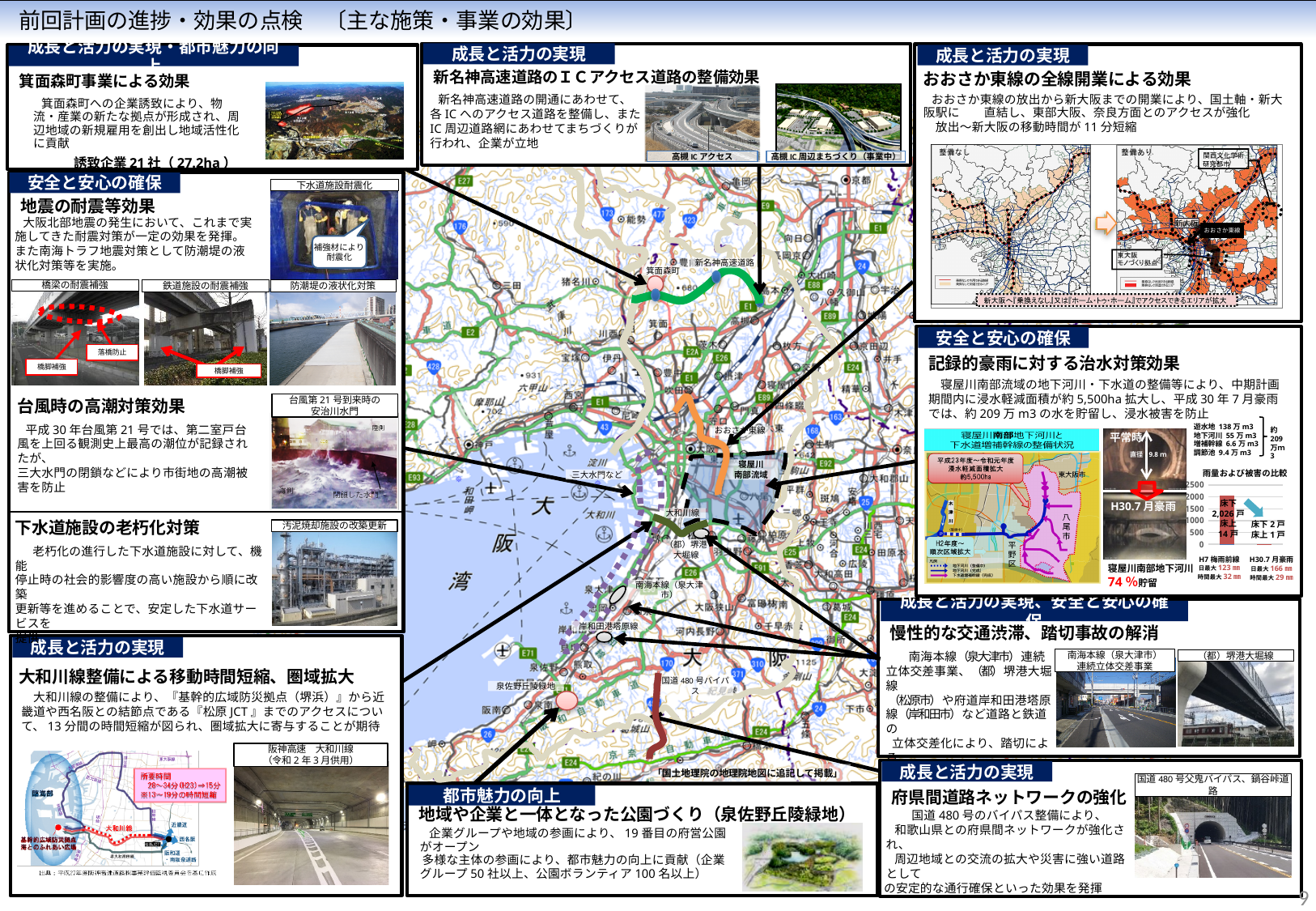
In the 「雨量および被害の比較」 chart, what is the 床下 value for H30.7月豪雨? 2戸 In the 「雨量および被害の比較」 chart, what is the 床上 value for H30.7月豪雨? 1戸 In the 「雨量および被害の比較」 chart, what is the difference between the 床下 values for H7 梅雨前線 and H30.7月豪雨? 2,024戸 In the 「雨量および被害の比較」 chart, which event has the higher 床下 value, H7 梅雨前線 or H30.7月豪雨? H7 梅雨前線 In the 「雨量および被害の比較」 chart, do the 床下 values rise or fall from H7 梅雨前線 to H30.7月豪雨? fall In the 「雨量および被害の比較」 chart, is the 床下 value for H7 梅雨前線 greater or less than 2000? greater In the 「雨量および被害の比較」 chart, how many events (categories) are compared? 2 In the 「雨量および被害の比較」 chart, what is the 床下 (below-floor flooding) value for H7 梅雨前線? 2,026戸 In the 「雨量および被害の比較」 chart, what is the highest value shown on the vertical axis? 2500 What kind of chart is the small chart titled 「雨量および被害の比較」 in the 「記録的豪雨に対する治水対策効果」 panel? bar chart In the 「雨量および被害の比較」 chart, what is the 床上 (above-floor flooding) value for H7 梅雨前線? 14戸